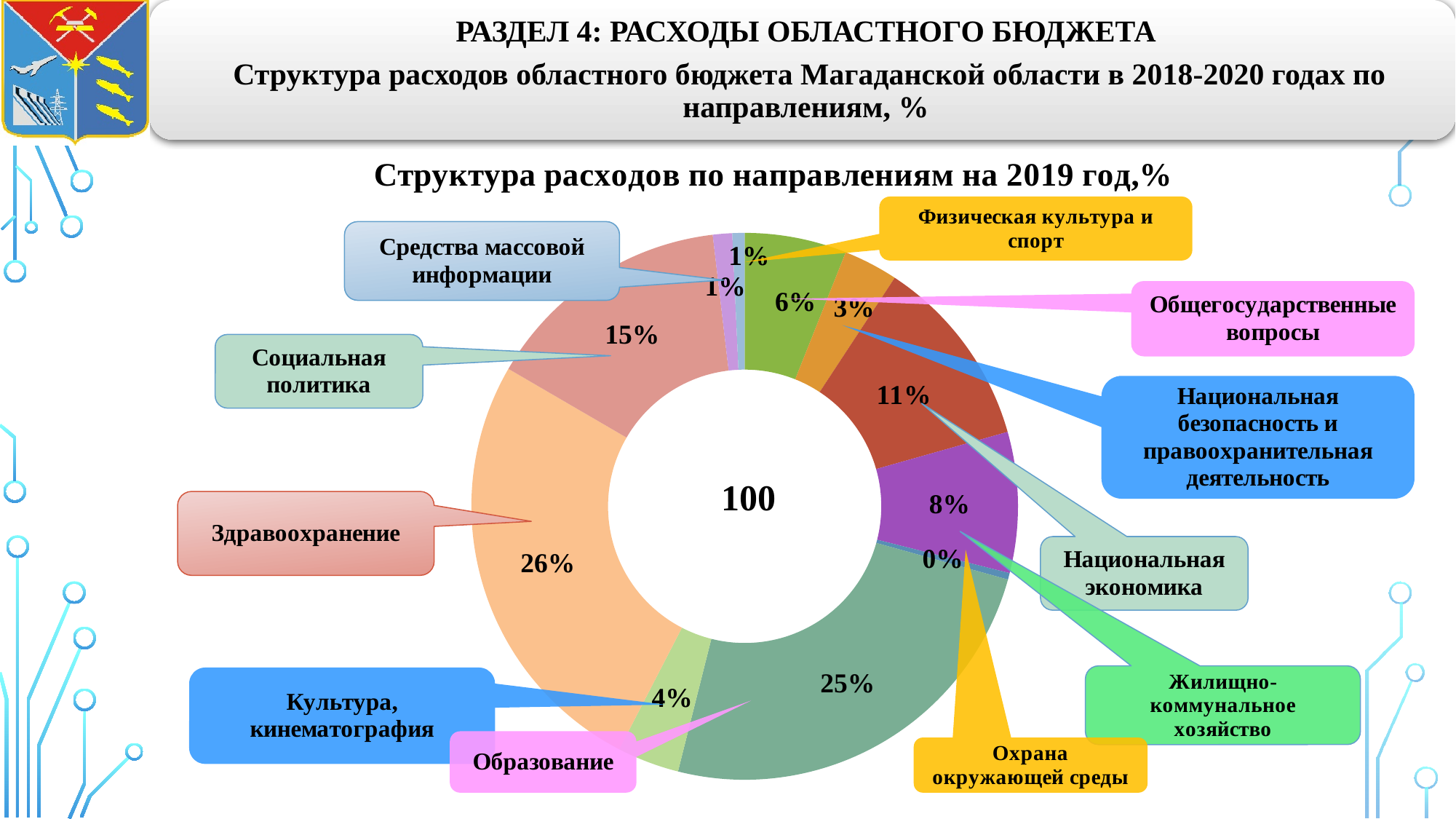
Which direction has the largest share of expenditures? Здравоохранение What share of expenditures goes to Образование? 25% What share of expenditures goes to Здравоохранение? 26% What is the title of the chart? Структура расходов по направлениям на 2019 год,% What share of expenditures goes to Охрана окружающей среды? 0% Which direction has the smallest share of expenditures? Охрана окружающей среды What share of expenditures goes to Социальная политика? 15% What kind of chart is shown on the slide? Pie (doughnut) chart What share of expenditures goes to Культура, кинематография? 4% What number is shown in the centre of the doughnut chart? 100 Which is larger: the share for Социальная политика or the share for Культура, кинематография? Социальная политика What is the difference in percentage points between Здравоохранение and Образование? 1